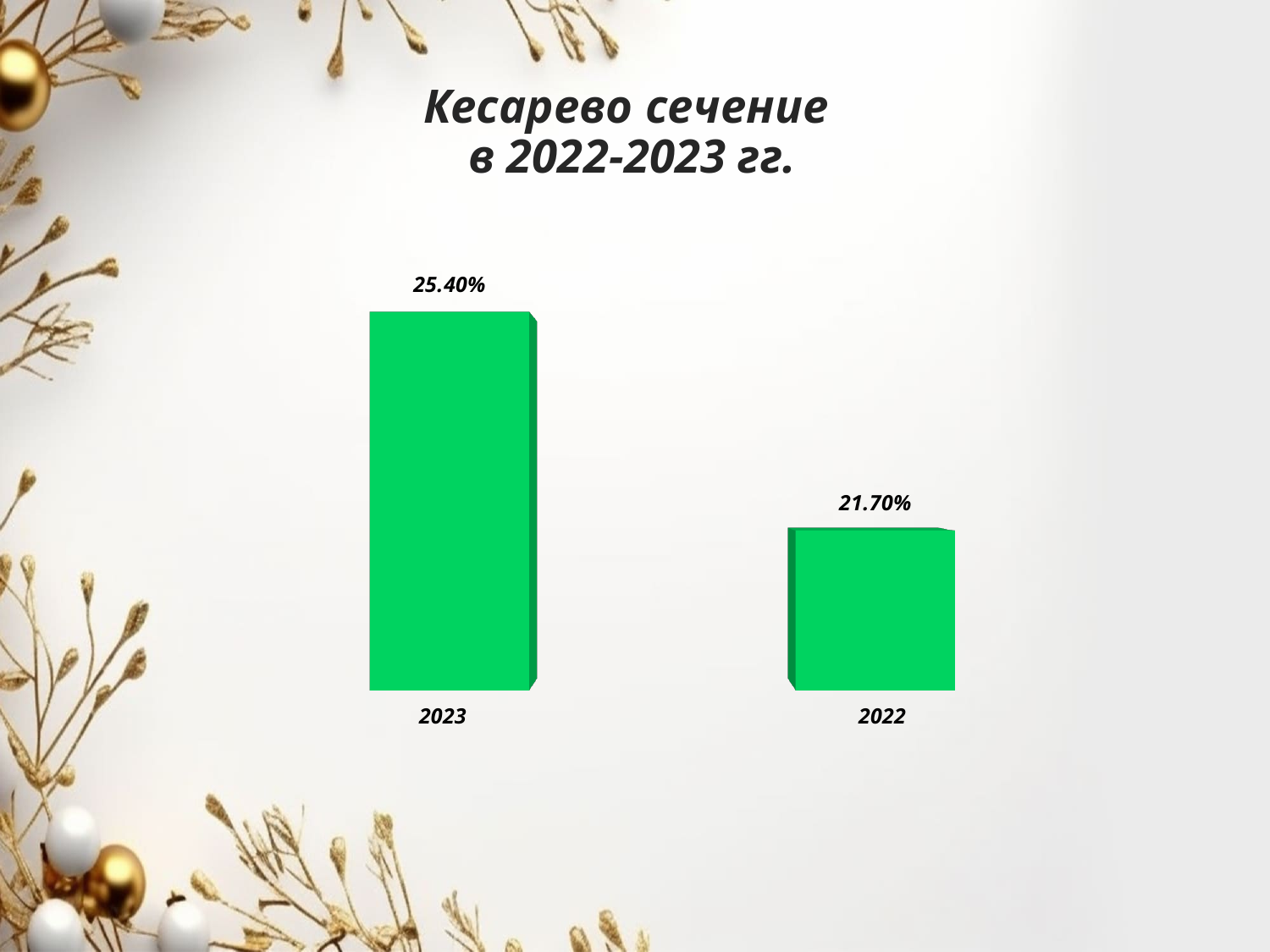
What is the value for 2022? 21.70% What is the value for 2023? 25.40% What kind of chart is shown on the slide? bar chart What is the difference between the 2023 and 2022 values? 3.70% Which year is shown on the left side of the chart? 2023 Which year has the lower value? 2022 What is the title of the chart? Кесарево сечение в 2022-2023 гг. What colour are the bars in the chart? green Is the value for 2022 larger or smaller than the value for 2023? smaller Which year has the higher value? 2023 How many bars are shown in the chart? 2